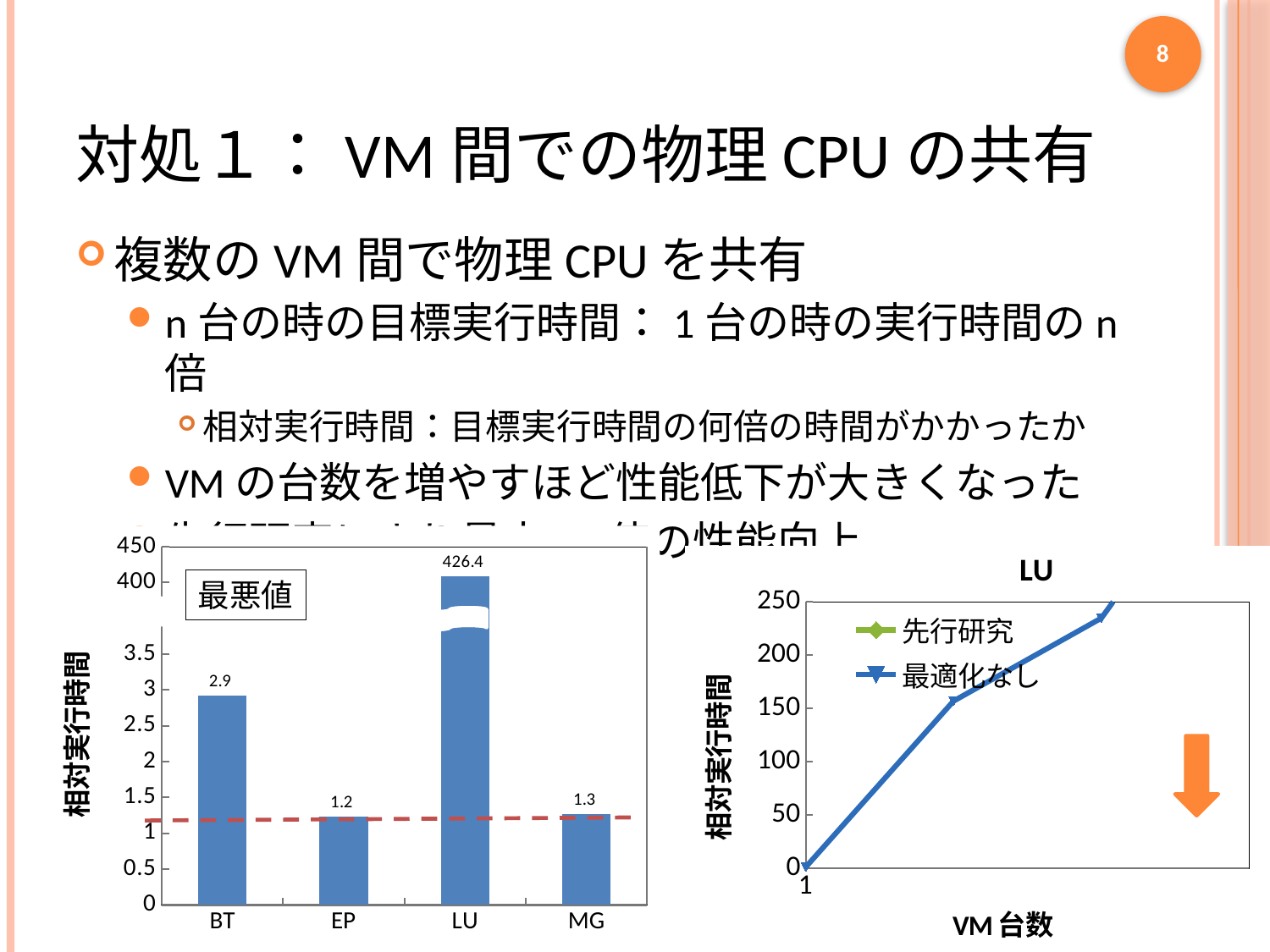
In the bar chart on the left, what is the difference between the values for BT and MG? 1.6 In the bar chart on the left, what is the value for EP? 1.2 In the bar chart on the left, which category has the lowest value? EP How many series does the legend of the chart on the right list? 2 What kind of chart is the chart on the left? bar chart What is the title of the chart on the right? LU In the bar chart on the left, which is larger, the value for BT or the value for MG? BT In the bar chart on the left, what is the value for MG? 1.3 How many categories are shown in the bar chart on the left? 4 In the bar chart on the left, what is the value for LU? 426.4 In the bar chart on the left, what is the value for BT? 2.9 In the bar chart on the left, which category has the highest value? LU